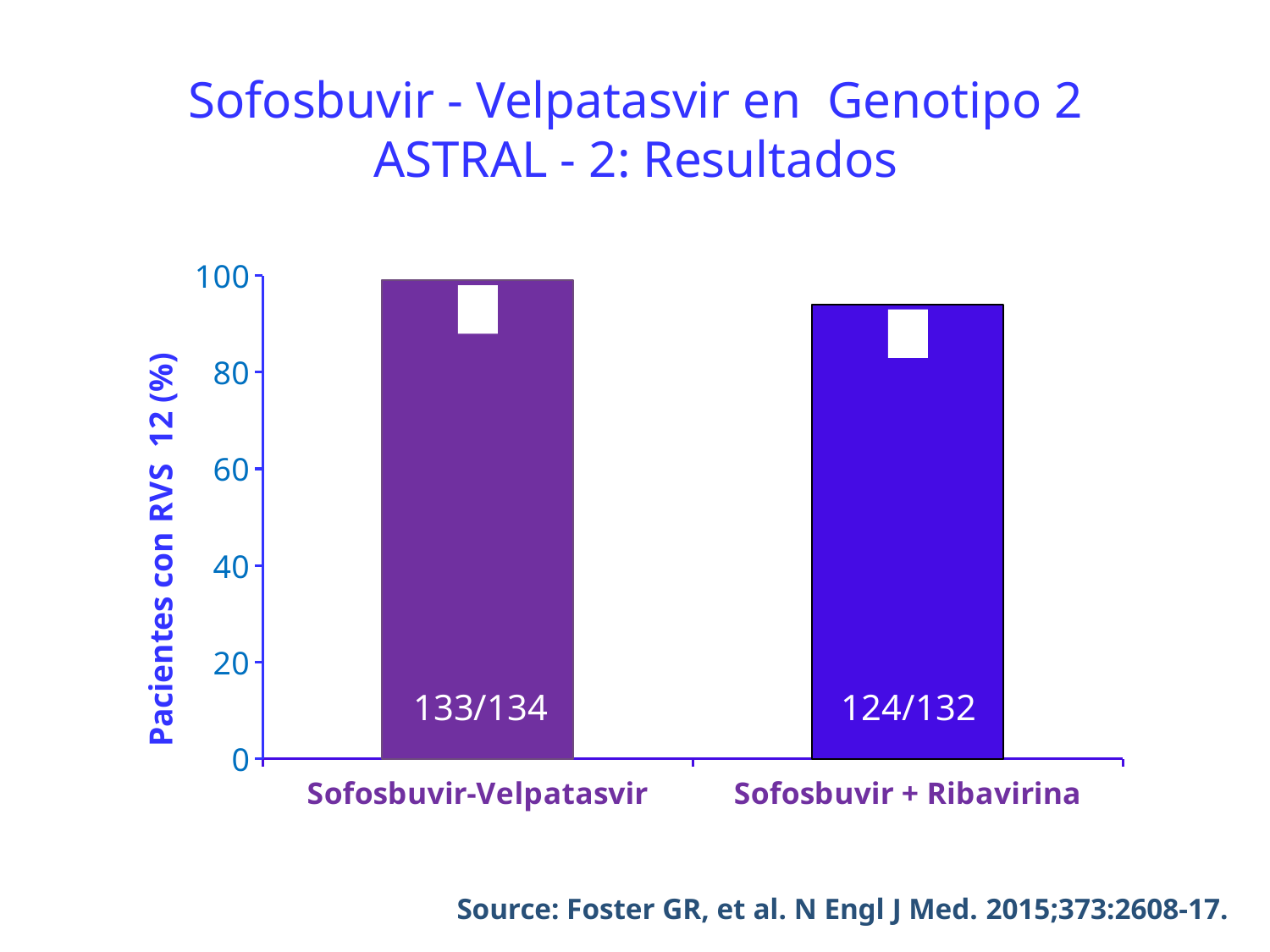
What label is printed on the bar for Sofosbuvir + Ribavirina? 124/132 What is the title of the slide containing the chart? Sofosbuvir - Velpatasvir en Genotipo 2 ASTRAL - 2: Resultados Is the value for Sofosbuvir + Ribavirina greater or less than 80? greater What kind of chart is shown on the slide? bar chart Is the value for Sofosbuvir-Velpatasvir greater or less than 80? greater What label is printed on the bar for Sofosbuvir-Velpatasvir? 133/134 Is the bar for Sofosbuvir-Velpatasvir taller or shorter than the bar for Sofosbuvir + Ribavirina? taller What is the label of the vertical axis? Pacientes con RVS 12 (%) How many bars (treatment groups) are plotted in the chart? 2 Is the value for Sofosbuvir + Ribavirina greater or less than 100? less Which treatment group has the higher bar? Sofosbuvir-Velpatasvir Which treatment group has the lower bar? Sofosbuvir + Ribavirina